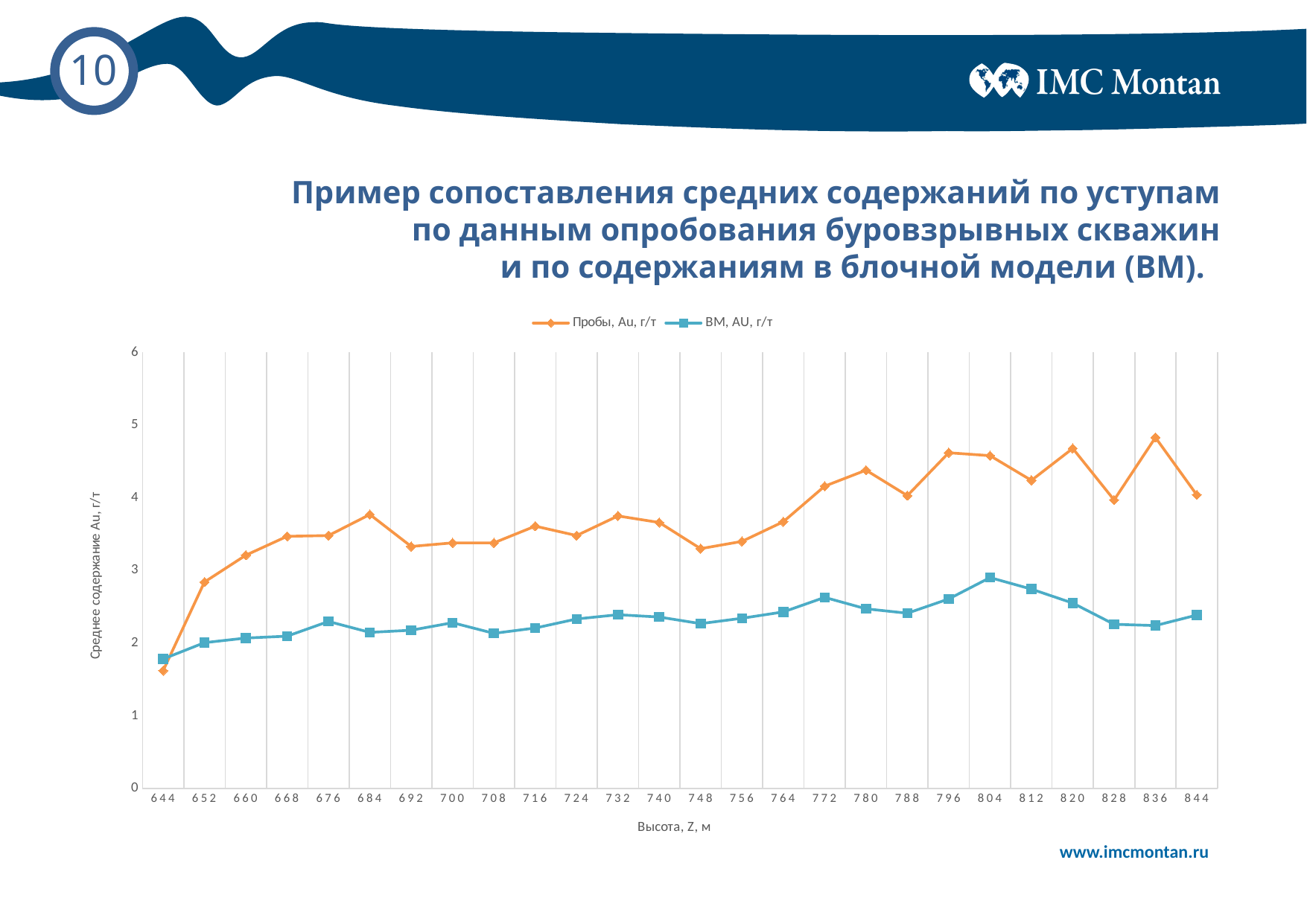
What kind of chart is shown on the slide? line chart How many points along the x axis (Высота, Z, м) does each series have? 26 At which height Z is the value of the 'BM, AU, г/т' series lowest? 644 Is the value for 'Пробы, Au, г/т' at height 748 greater or less than 3? greater At which height Z is the value of the 'BM, AU, г/т' series highest? 804 At height 804, which series has the larger value, 'Пробы, Au, г/т' or 'BM, AU, г/т'? Пробы, Au, г/т How many series does the legend list? 2 What is the label of the x axis? Высота, Z, м Is the value for 'BM, AU, г/т' at height 828 greater or less than 3? less At which height Z is the value of the 'Пробы, Au, г/т' series highest? 836 Is the value for 'Пробы, Au, г/т' at height 836 greater or less than 4? greater At which height Z is the value of the 'Пробы, Au, г/т' series lowest? 644